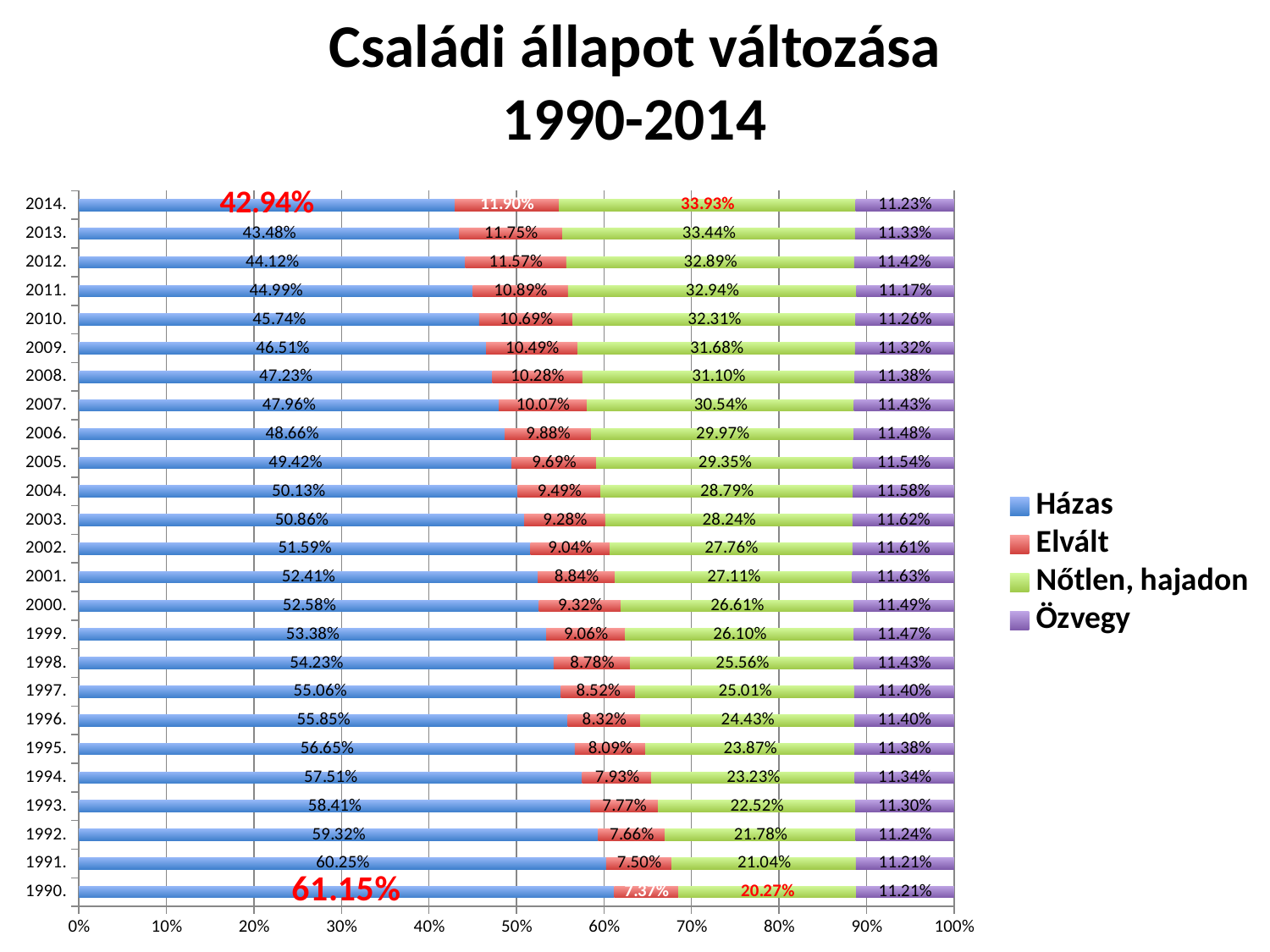
What is the value for Elvált in 1990? 7.37% What is the value for Özvegy in 2000? 11.49% In which year is the Házas share the highest? 1990 What kind of chart is shown on the slide? Stacked bar chart In which year is the Nőtlen, hajadon share the lowest? 1990 By how many percentage points did the Házas share fall from 1990 to 2014? 18.21 percentage points In 2014, which is larger: the Elvált share or the Özvegy share? Elvált What is the value for Házas in 1990? 61.15% How many years are shown on the chart? 25 What is the value for Házas in 2014? 42.94% What is the value for Nőtlen, hajadon in 2014? 33.93% How many series does the legend list? 4